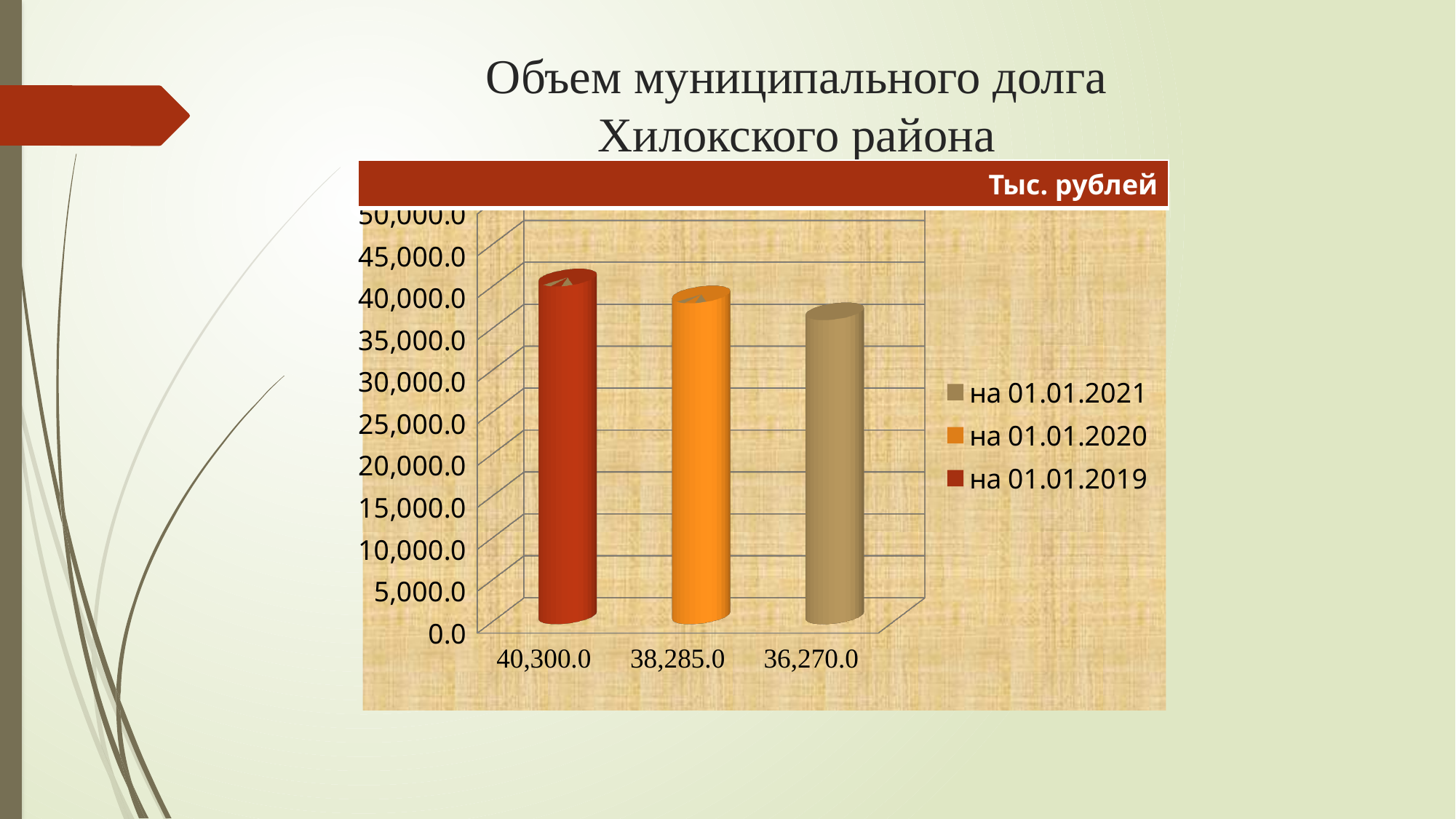
What is the difference between the values for на 01.01.2020 and на 01.01.2021? 2,015.0 What is the municipal debt value shown for на 01.01.2020? 38,285.0 What is the difference between the values for на 01.01.2019 and на 01.01.2021? 4,030.0 Which date has the lowest municipal debt value? на 01.01.2021 Which is larger, the value for на 01.01.2020 or the value for на 01.01.2021? на 01.01.2020 How many entries does the legend list? 3 What is the municipal debt value shown for на 01.01.2021? 36,270.0 Is the value for на 01.01.2021 greater or less than 35,000.0? greater How many bars are plotted in the chart? 3 Do the values rise or fall from 01.01.2019 to 01.01.2021? fall What is the municipal debt value shown for на 01.01.2019? 40,300.0 Which date has the highest municipal debt value? на 01.01.2019